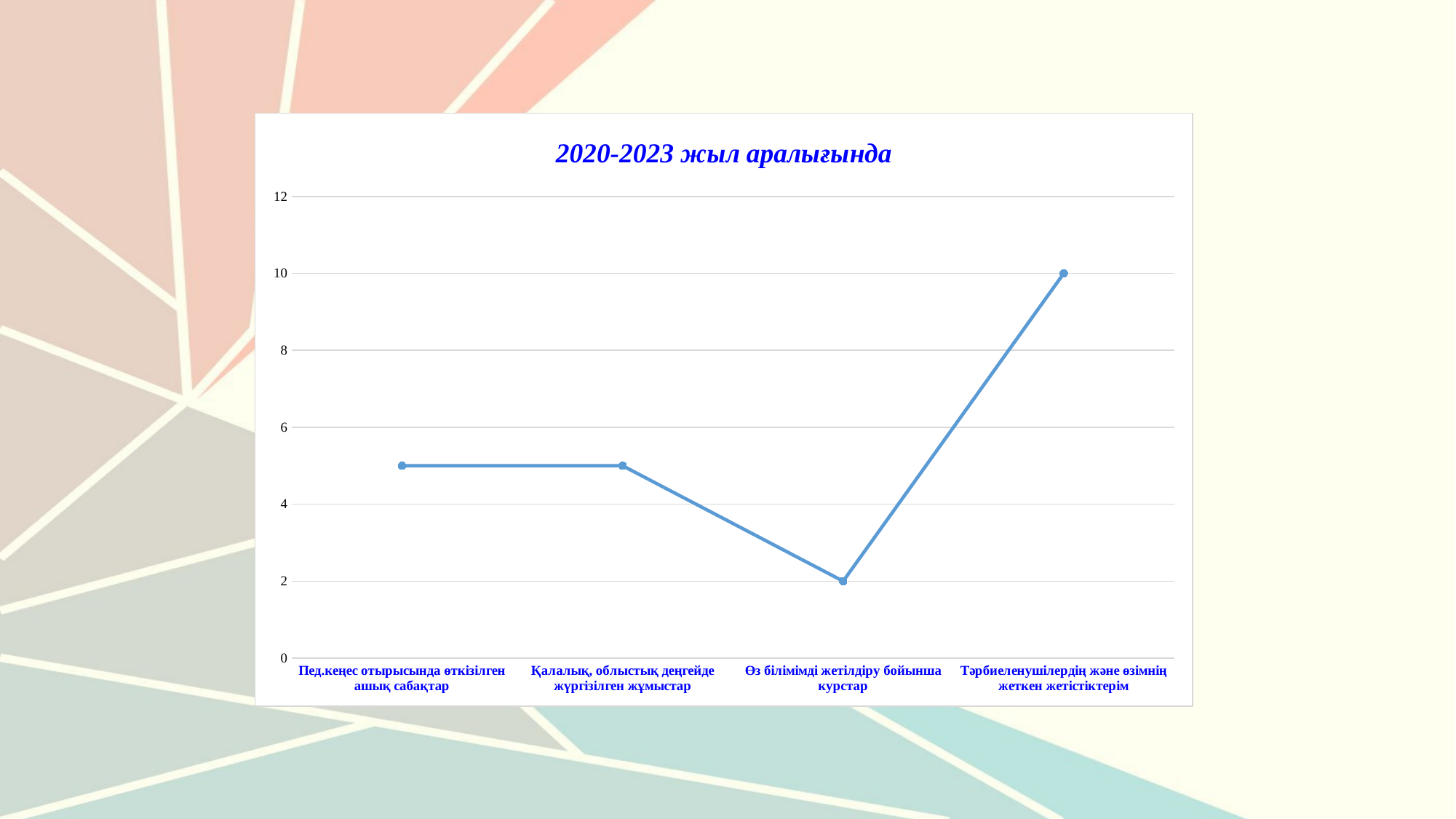
How many categories are plotted on the x axis? 4 Does the line rise or fall between "Өз білімімді жетілдіру бойынша курстар" and "Тәрбиеленушілердің және өзімнің жеткен жетістіктерім"? rise What kind of chart is shown on the slide? line chart Which category has the lowest value? Өз білімімді жетілдіру бойынша курстар Is the value for "Қалалық, облыстық деңгейде жүргізілген жұмыстар" greater or less than 4? greater Which is larger: the value for "Пед.кеңес отырысында өткізілген ашық сабақтар" or the value for "Өз білімімді жетілдіру бойынша курстар"? Пед.кеңес отырысында өткізілген ашық сабақтар What is the value for "Тәрбиеленушілердің және өзімнің жеткен жетістіктерім"? 10 What is the title of the chart? 2020-2023 жыл аралығында What is the value for "Өз білімімді жетілдіру бойынша курстар"? 2 What is the difference between the values for "Тәрбиеленушілердің және өзімнің жеткен жетістіктерім" and "Өз білімімді жетілдіру бойынша курстар"? 8 Is the value for "Пед.кеңес отырысында өткізілген ашық сабақтар" greater or less than 6? less Which category has the highest value? Тәрбиеленушілердің және өзімнің жеткен жетістіктерім